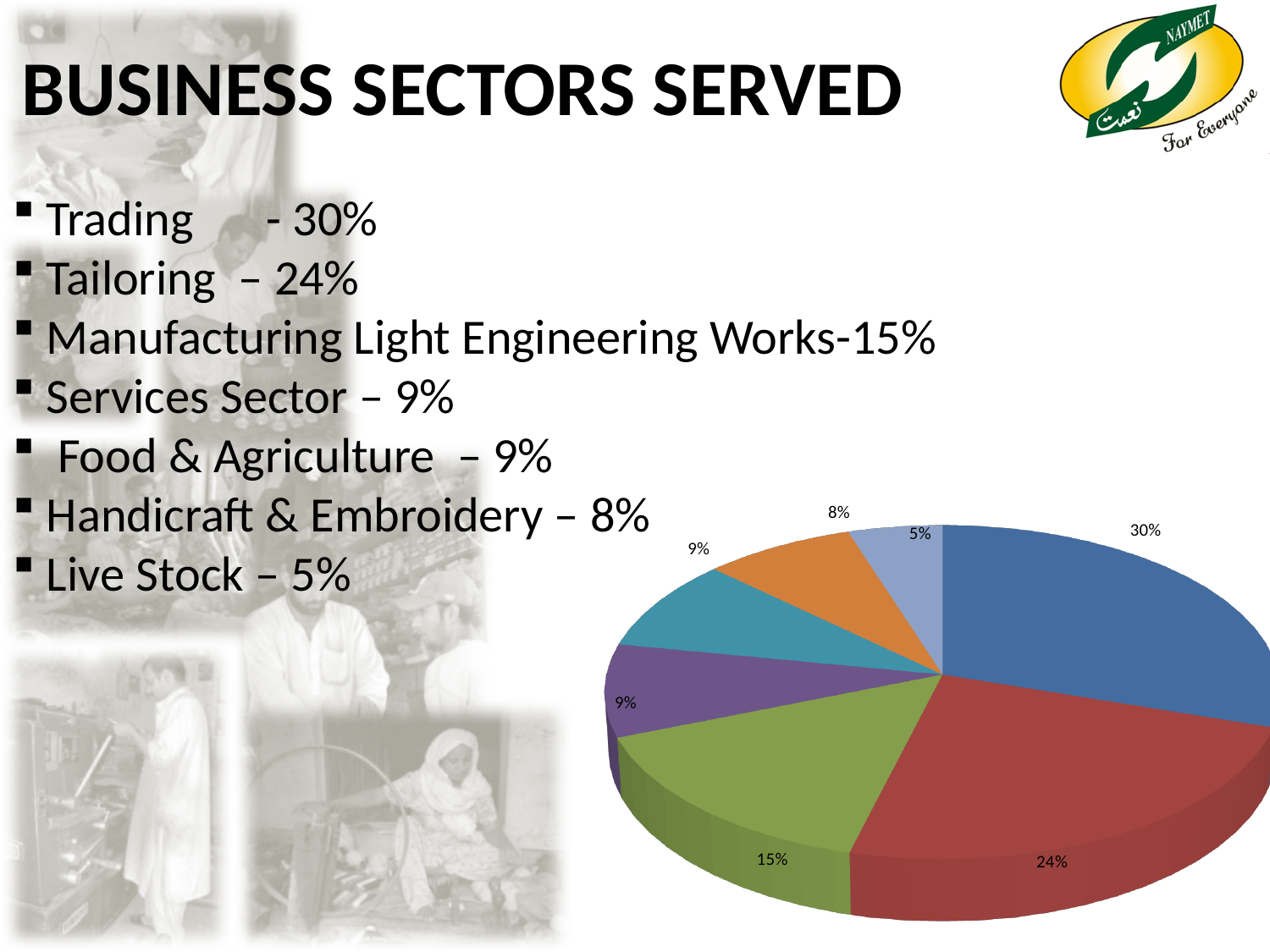
Which is larger in the pie chart, the 15% slice or the 24% slice? the 24% slice According to the slide, what share is Tailoring? 24% What is the largest slice's share in the pie chart? 30% What is the smallest slice's share in the pie chart? 5% How many slices does the pie chart have? 7 According to the slide, what share of business sectors served is Trading? 30% How many slices in the pie chart are labelled 9%? 2 What is the title of the slide containing the pie chart? BUSINESS SECTORS SERVED According to the slide, what share is Manufacturing Light Engineering Works? 15% What kind of chart is shown on the slide? pie chart According to the slide, what share is Live Stock? 5% What is the difference between the largest slice (30%) and the second largest slice (24%) in the pie chart? 6%